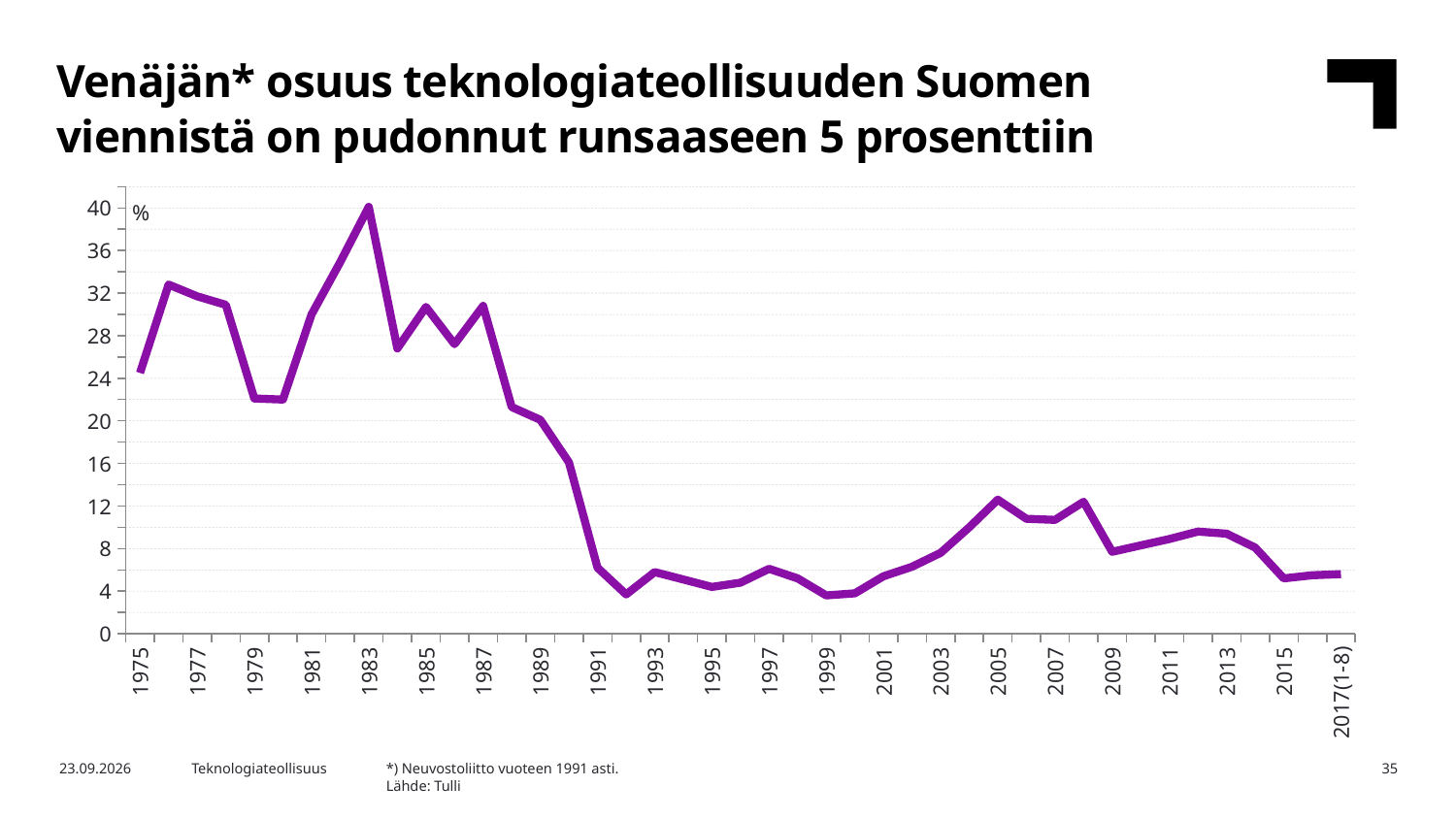
Which year has the larger value, 1977 or 1979? 1977 Is the value for 1991 greater or less than 8? less In which year does the line reach its highest value? 1983 Is the value for 1983 greater or less than 36? greater What source is given for the chart data? Tulli Is the value for 2017(1-8) greater or less than 8? less What unit is shown on the vertical axis of the chart? % Overall, does the line rise or fall from 1975 to 2017(1-8)? fall Which year has the larger value, 2005 or 2015? 2005 What kind of chart is shown on the slide? line chart